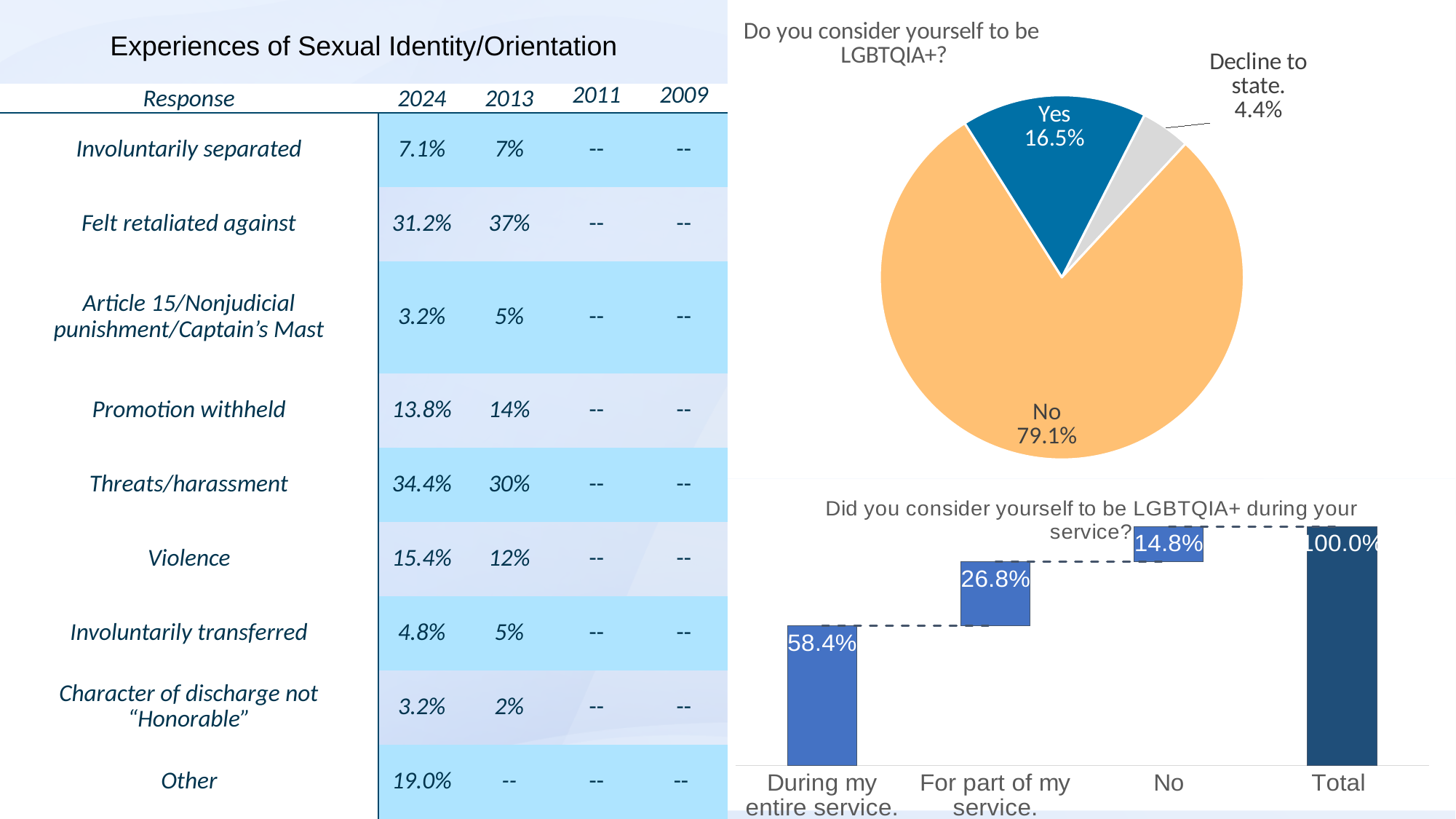
In the pie chart 'Do you consider yourself to be LGBTQIA+?', what share of respondents answered No? 79.1% In the pie chart 'Do you consider yourself to be LGBTQIA+?', which response has the largest slice? No In the pie chart 'Do you consider yourself to be LGBTQIA+?', how many slices are there? 3 What kind of chart is 'Did you consider yourself to be LGBTQIA+ during your service?'? bar chart In the pie chart 'Do you consider yourself to be LGBTQIA+?', what share of respondents chose 'Decline to state'? 4.4% In the pie chart 'Do you consider yourself to be LGBTQIA+?', what is the difference between the No and Yes shares? 62.6% In the chart 'Did you consider yourself to be LGBTQIA+ during your service?', what is the value for 'For part of my service.'? 26.8% In the chart 'Did you consider yourself to be LGBTQIA+ during your service?', what is the value for 'During my entire service.'? 58.4% In the pie chart 'Do you consider yourself to be LGBTQIA+?', which response has the smallest slice? Decline to state In the chart 'Did you consider yourself to be LGBTQIA+ during your service?', what is the value for 'No'? 14.8% In the chart 'Did you consider yourself to be LGBTQIA+ during your service?', which is larger: 'For part of my service.' or 'No'? For part of my service. In the pie chart 'Do you consider yourself to be LGBTQIA+?', what share of respondents answered Yes? 16.5%